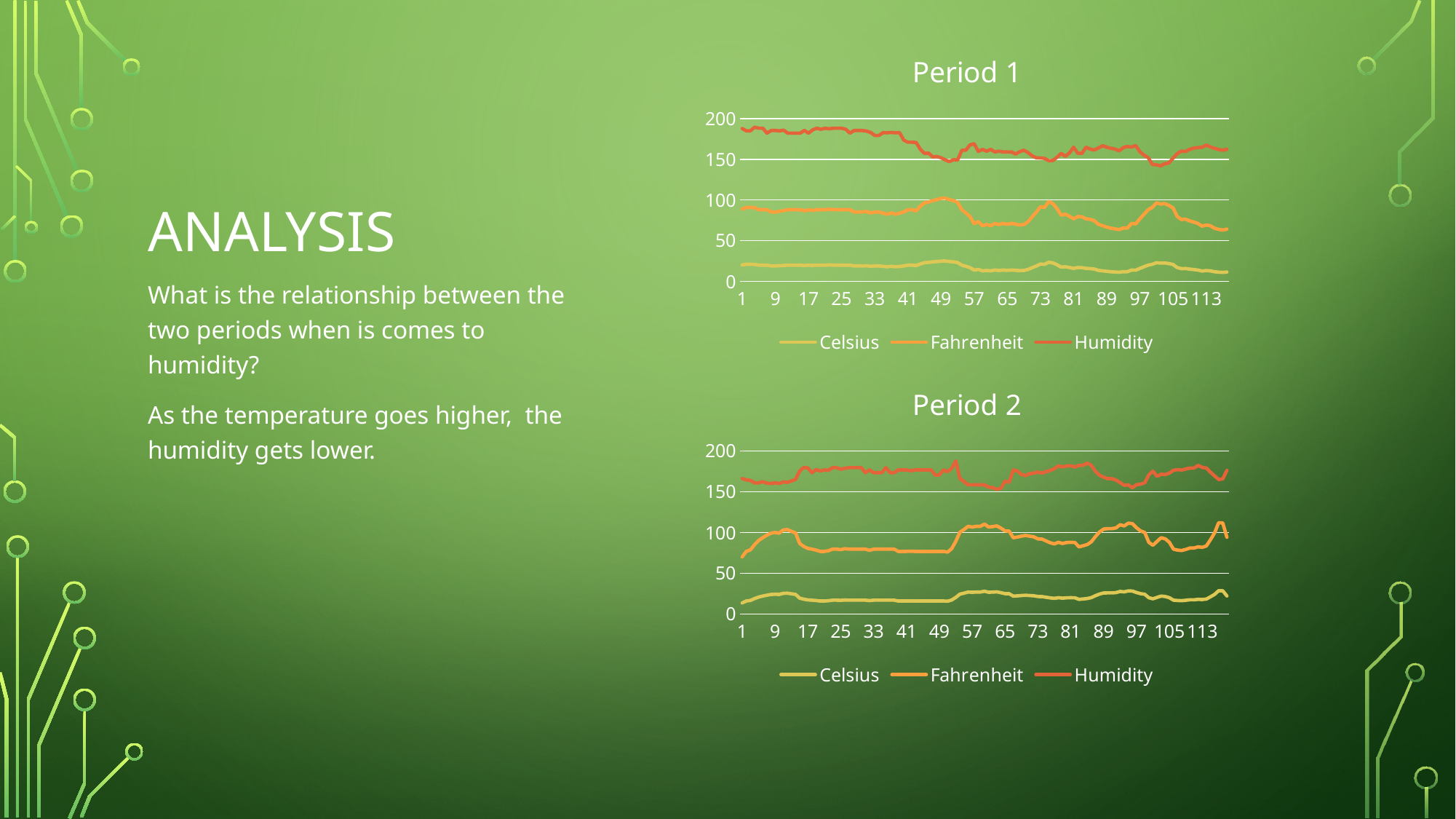
What are the titles of the two charts on the slide? Period 1 and Period 2 How many series does the legend of the Period 2 chart list? 3 What kind of chart is the Period 1 chart? line chart In the Period 2 chart, is the Fahrenheit value at point 1 greater or less than 100? less In the Period 1 chart, does the Humidity line overall rise or fall from the first point to the last point? fall In the Period 1 chart, is the Fahrenheit value at point 1 greater or less than 100? less What are the names of the series in the Period 1 chart's legend? Celsius, Fahrenheit, Humidity In the Period 1 chart, which is larger at point 1: Humidity or Fahrenheit? Humidity In the Period 1 chart, which series has the lowest values throughout? Celsius